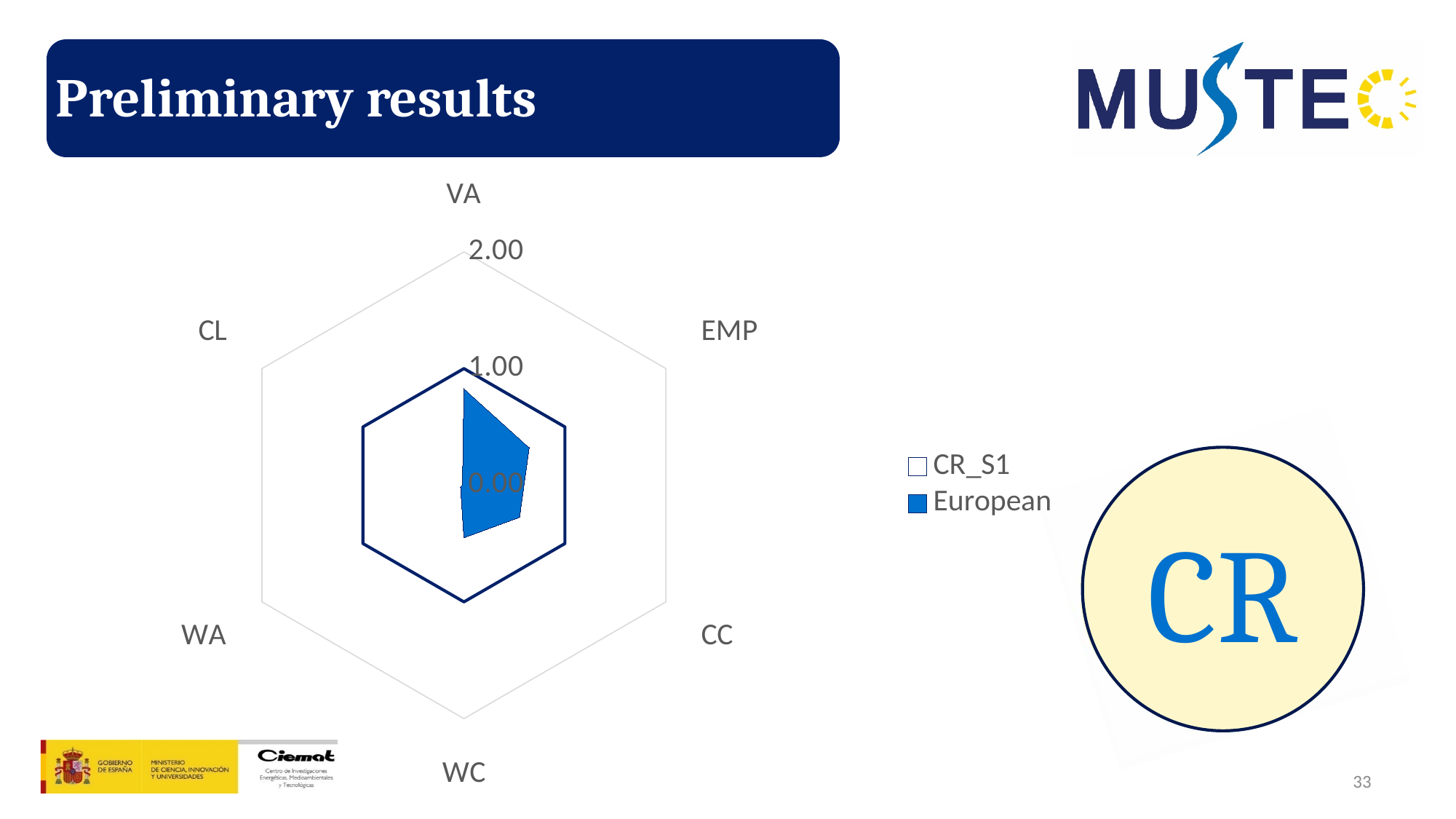
Is the European value for EMP greater or less than 1.00? less For VA, which series has the larger value, CR_S1 or European? CR_S1 How many series does the legend of the radar chart list? 2 Which series in the radar chart is drawn as a filled blue area? European What kind of chart is shown on the slide? Radar chart On which axis does the European series reach its highest value? VA What is the value of CR_S1 for WC in the radar chart? 1.00 What is the value of CR_S1 for VA in the radar chart? 1.00 How many categories (axes) does the radar chart have? 6 Is the European value for VA greater or less than 1.00? less What are the names of the two series in the radar chart legend? CR_S1 and European Is the CR_S1 value for EMP greater or less than 2.00? less